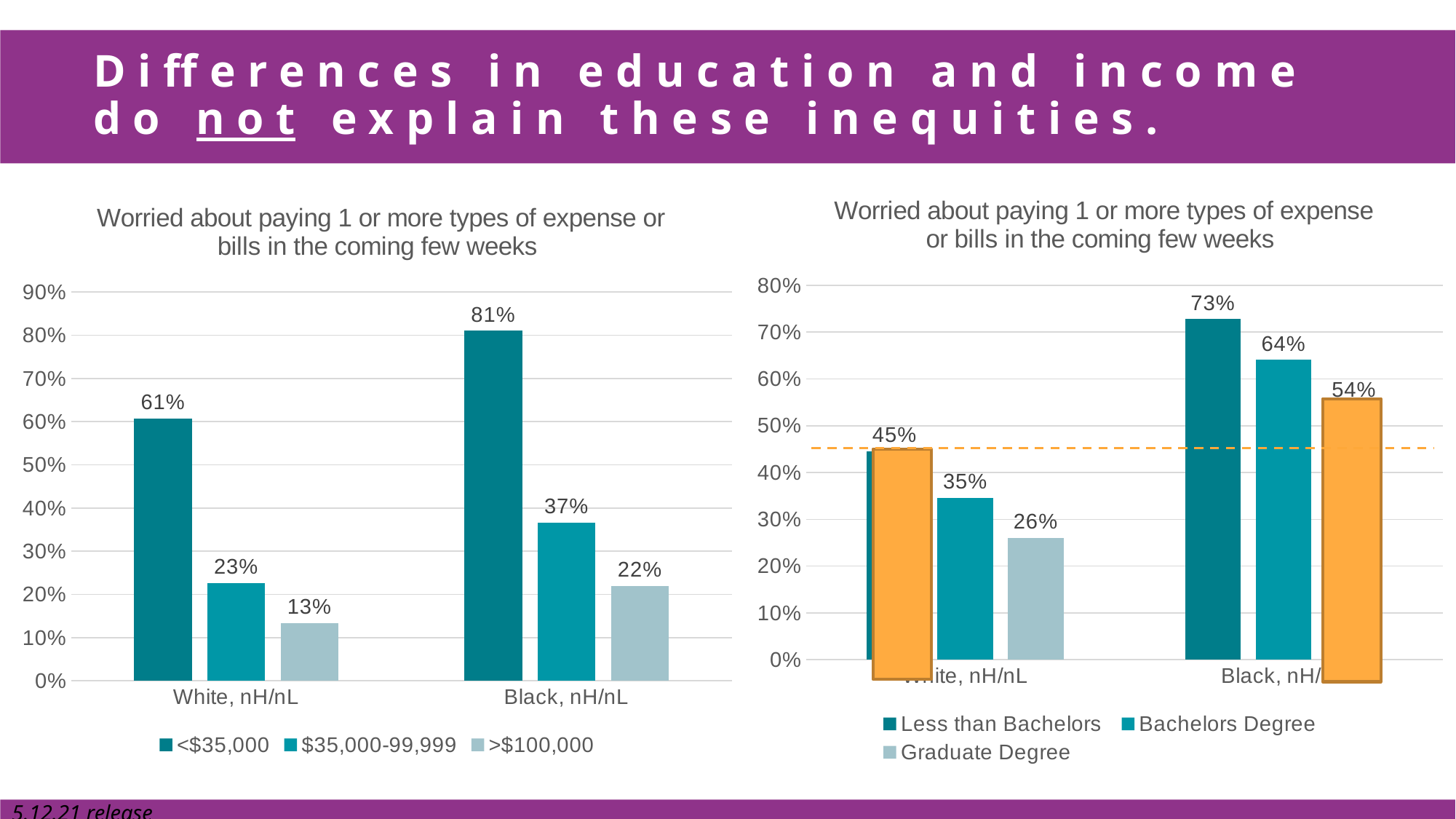
In the left chart, which series has the highest value for White, nH/nL? <$35,000 In the right chart, what is the value for Bachelors Degree for Black, nH/nL? 64% In the right chart, which is larger: Graduate Degree for Black, nH/nL or Less than Bachelors for White, nH/nL? Graduate Degree for Black, nH/nL In the left chart, what is the value for the >$100,000 series for White, nH/nL? 13% In the right chart, which series has the lowest value for Black, nH/nL? Graduate Degree In the right chart, what is the difference between the Less than Bachelors values for Black, nH/nL and White, nH/nL? 28% In the left chart, what is the difference between the $35,000-99,999 values for Black, nH/nL and White, nH/nL? 14% In the left chart, what is the value for the <$35,000 series for Black, nH/nL? 81% How many series does the legend of the left chart list? 3 In the right chart, what is the value for Graduate Degree for White, nH/nL? 26% What type of chart is the right chart? Bar chart How many categories are shown on the x axis of the left chart? 2